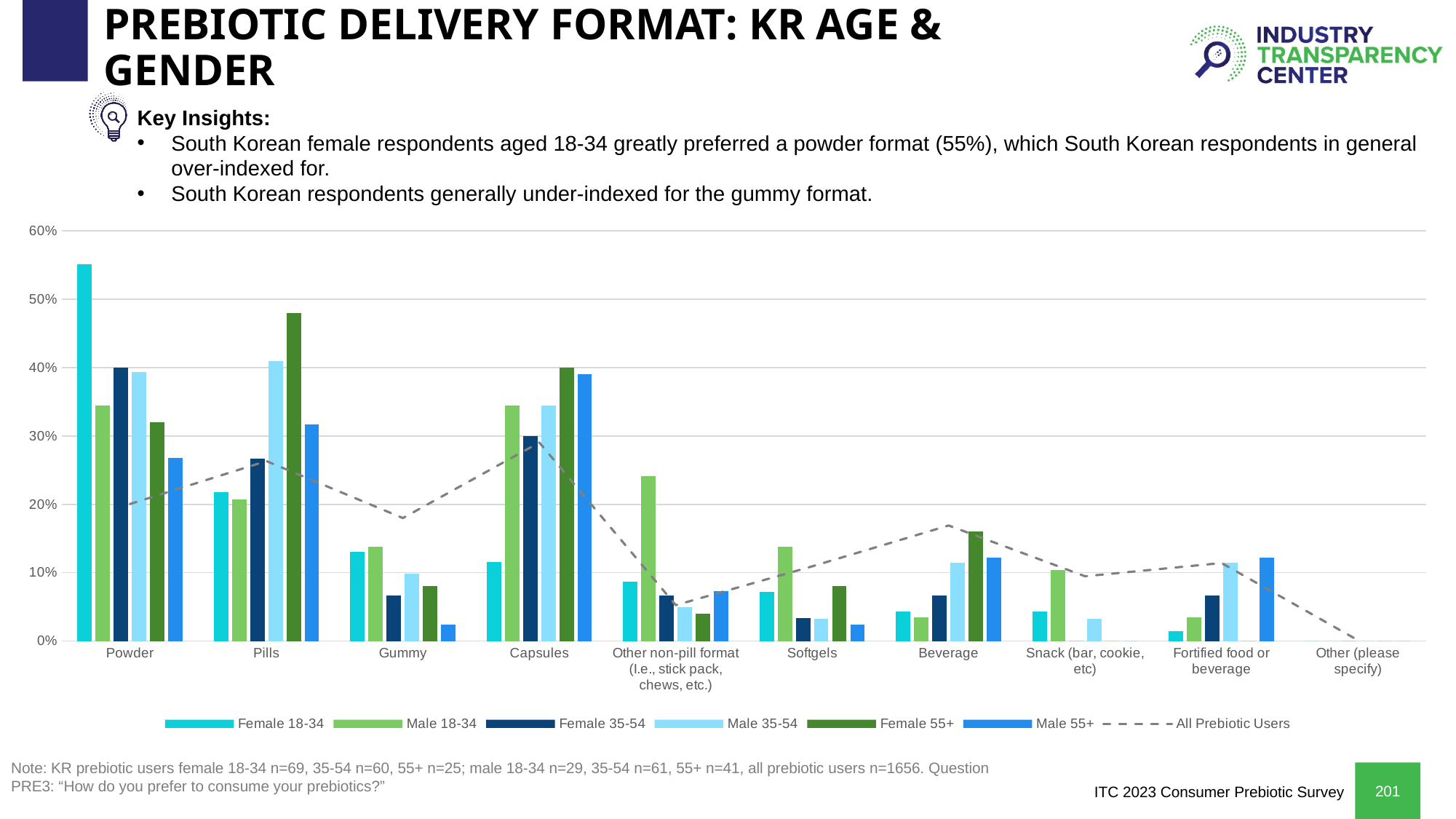
In the Pills category, which is larger: Female 55+ or Male 55+? Female 55+ Does the All Prebiotic Users line rise or fall from Pills to Gummy? fall What does the dashed grey line represent? All Prebiotic Users Which category has the highest Female 18-34 bar? Powder Is the value for Female 55+ in the Pills category greater or less than 40%? greater In the Capsules category, which is larger: Male 18-34 or Female 35-54? Male 18-34 Is the value for Male 55+ in the Gummy category greater or less than 10%? less Is the value for Female 18-34 in the Powder category greater or less than 50%? greater How many series does the legend list? 7 What kind of chart is shown on the slide? combination bar and line chart How many delivery format categories are shown on the x axis? 10